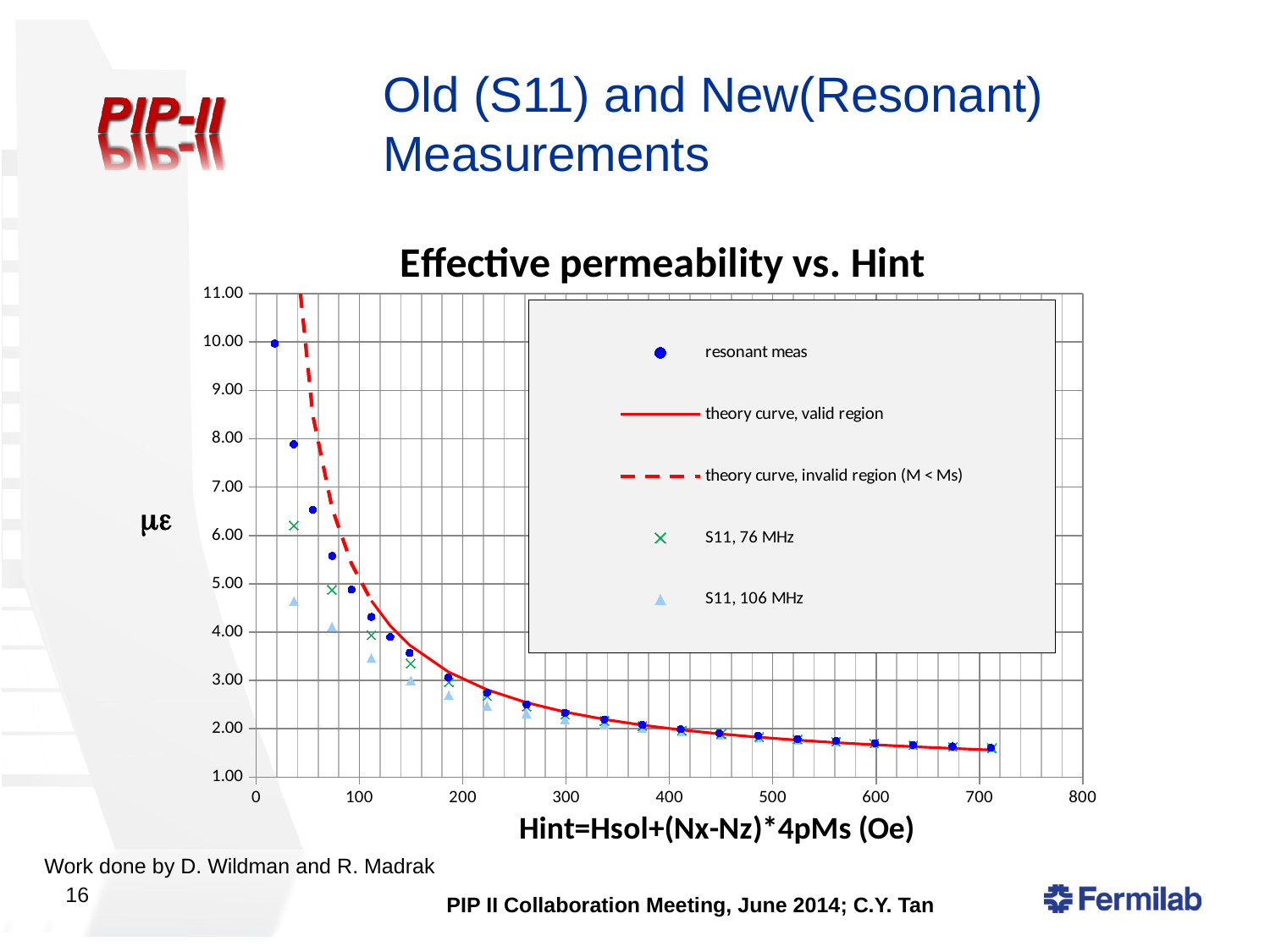
What is the label of the x axis? Hint=Hsol+(Nx-Nz)*4pMs (Oe) How many entries does the chart legend list? 5 Which measured series has the lowest effective permeability at low Hint? S11, 106 MHz Do the resonant meas values rise or fall as Hint increases? fall Is the first S11, 106 MHz point (near Hint = 30) greater or less than 5.00? less Is the resonant meas value near Hint = 700 greater or less than 2.00? less What is the title of the chart? Effective permeability vs. Hint Is the first resonant meas point (near Hint = 20) greater or less than 9.00? greater What kind of chart is shown on the slide? scatter chart Which measured series reaches the highest effective permeability at low Hint? resonant meas Near Hint = 30, which is larger: the resonant meas value or the S11, 106 MHz value? resonant meas